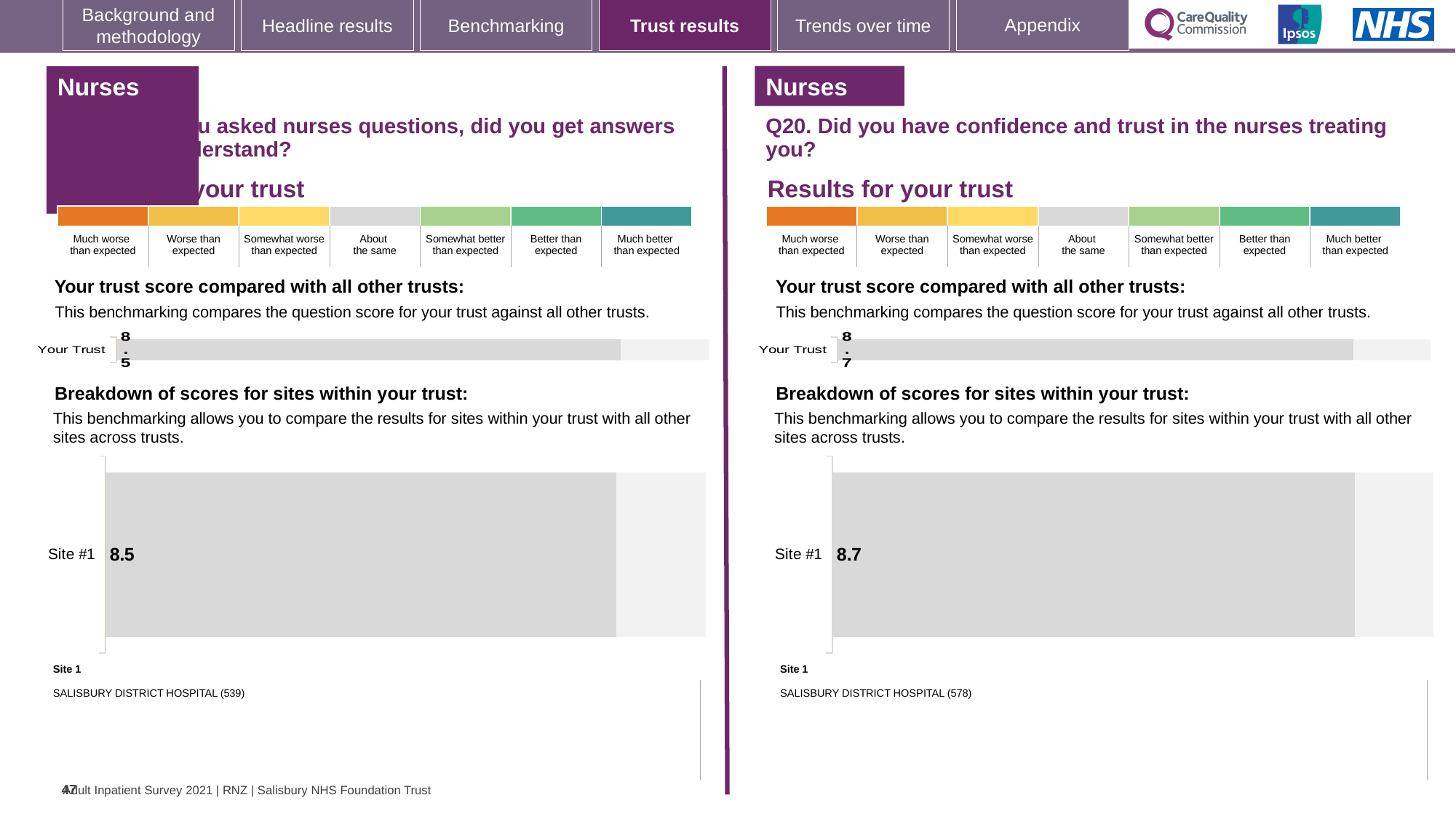
How many sites are shown in the 'Breakdown of scores for sites within your trust' chart on the left half of the slide? 1 Which site is listed as Site 1 below the breakdown chart on the right half of the slide (Q20)? SALISBURY DISTRICT HOSPITAL (578) Which is larger: the Your Trust score on the left half of the slide or the Your Trust score on the right half (Q20)? Q20 (right half) What type of chart is used to show the Site #1 score on the right half of the slide (Q20)? Bar chart What is the difference between the Site #1 score on the right half of the slide (Q20) and the Site #1 score on the left half? 0.2 In the 'Breakdown of scores for sites within your trust' chart on the left half of the slide, what is the score for Site #1? 8.5 What type of chart is used to show the Your Trust score on the left half of the slide? Bar chart Which site is listed as Site 1 below the breakdown chart on the left half of the slide? SALISBURY DISTRICT HOSPITAL (539) On the left half of the slide, what is the score shown for Your Trust in the 'Your trust score compared with all other trusts' chart? 8.5 In the 'Breakdown of scores for sites within your trust' chart on the right half of the slide (Q20), what is the score for Site #1? 8.7 On the right half of the slide (Q20), what is the score shown for Your Trust in the 'Your trust score compared with all other trusts' chart? 8.7 How many sites are shown in the 'Breakdown of scores for sites within your trust' chart on the right half of the slide (Q20)? 1